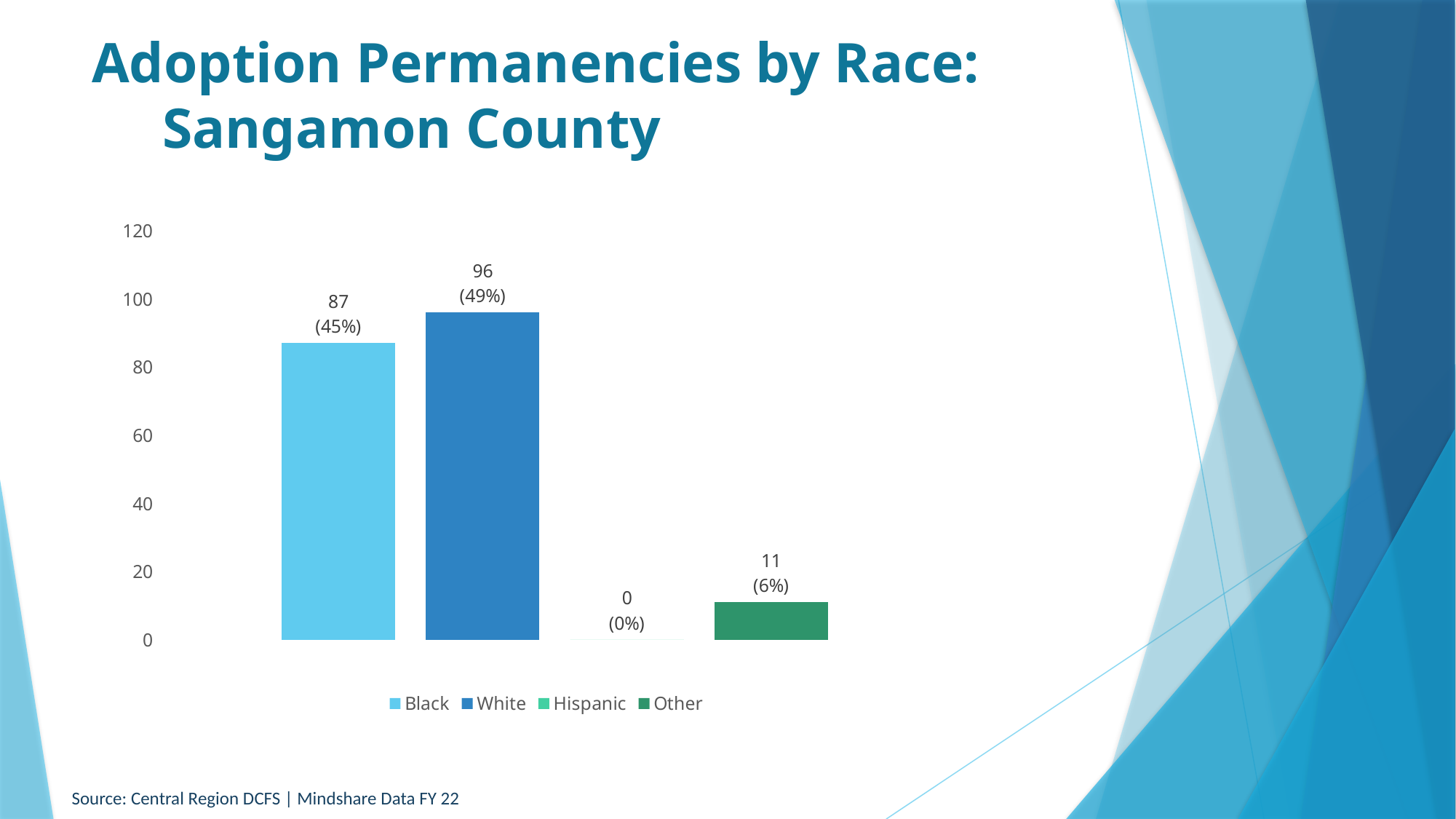
What is the value for Hispanic? 0 What kind of chart is shown on the slide? Bar chart What is the title of the slide? Adoption Permanencies by Race: Sangamon County What is the value for White? 96 Which is larger, the value for Black or the value for Other? Black Which category has the highest value? White What percentage is shown for Black? 45% What is the value for Other? 11 Which category has the lowest value? Hispanic What is the value for Black? 87 How many series does the legend list? 4 What is the difference between the values for White and Black? 9